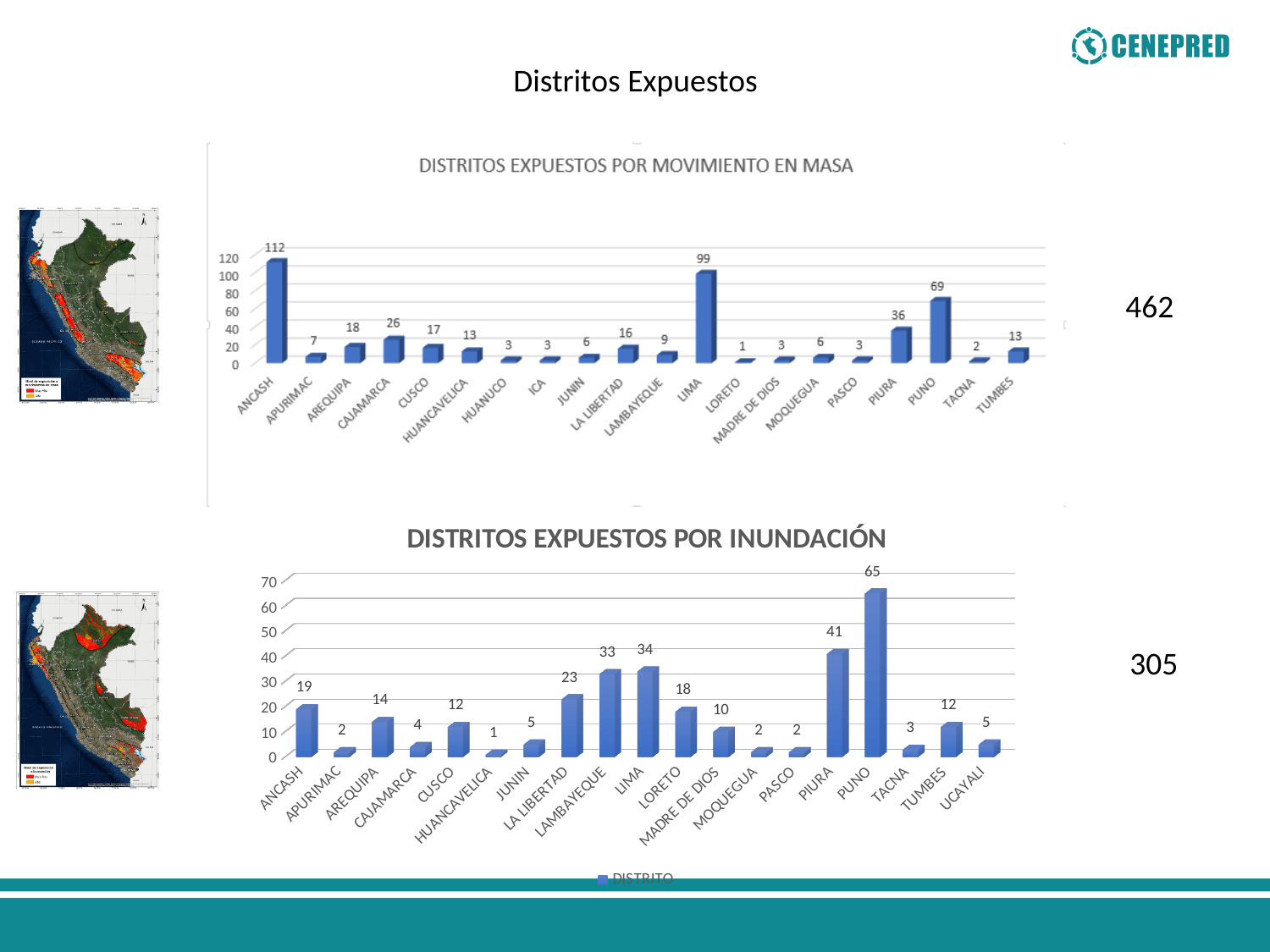
In the chart 'DISTRITOS EXPUESTOS POR INUNDACIÓN', which region has the highest value? PUNO What is the legend entry shown below the chart 'DISTRITOS EXPUESTOS POR INUNDACIÓN'? DISTRITO In the chart 'DISTRITOS EXPUESTOS POR MOVIMIENTO EN MASA', which region has the highest value? ANCASH In the chart 'DISTRITOS EXPUESTOS POR MOVIMIENTO EN MASA', what is the difference between the values for PUNO and PIURA? 33 In the chart 'DISTRITOS EXPUESTOS POR INUNDACIÓN', what is the difference between the values for PUNO and ANCASH? 46 In the chart 'DISTRITOS EXPUESTOS POR INUNDACIÓN', which is larger, the value for PIURA or the value for LIMA? PIURA In the chart 'DISTRITOS EXPUESTOS POR INUNDACIÓN', what is the value for LAMBAYEQUE? 33 What kind of chart is 'DISTRITOS EXPUESTOS POR INUNDACIÓN'? Bar chart In the chart 'DISTRITOS EXPUESTOS POR MOVIMIENTO EN MASA', which region has the lowest value? LORETO In the chart 'DISTRITOS EXPUESTOS POR MOVIMIENTO EN MASA', what is the value for LIMA? 99 In the chart 'DISTRITOS EXPUESTOS POR MOVIMIENTO EN MASA', how many regions are shown on the x axis? 20 In the chart 'DISTRITOS EXPUESTOS POR INUNDACIÓN', how many regions are shown on the x axis? 19